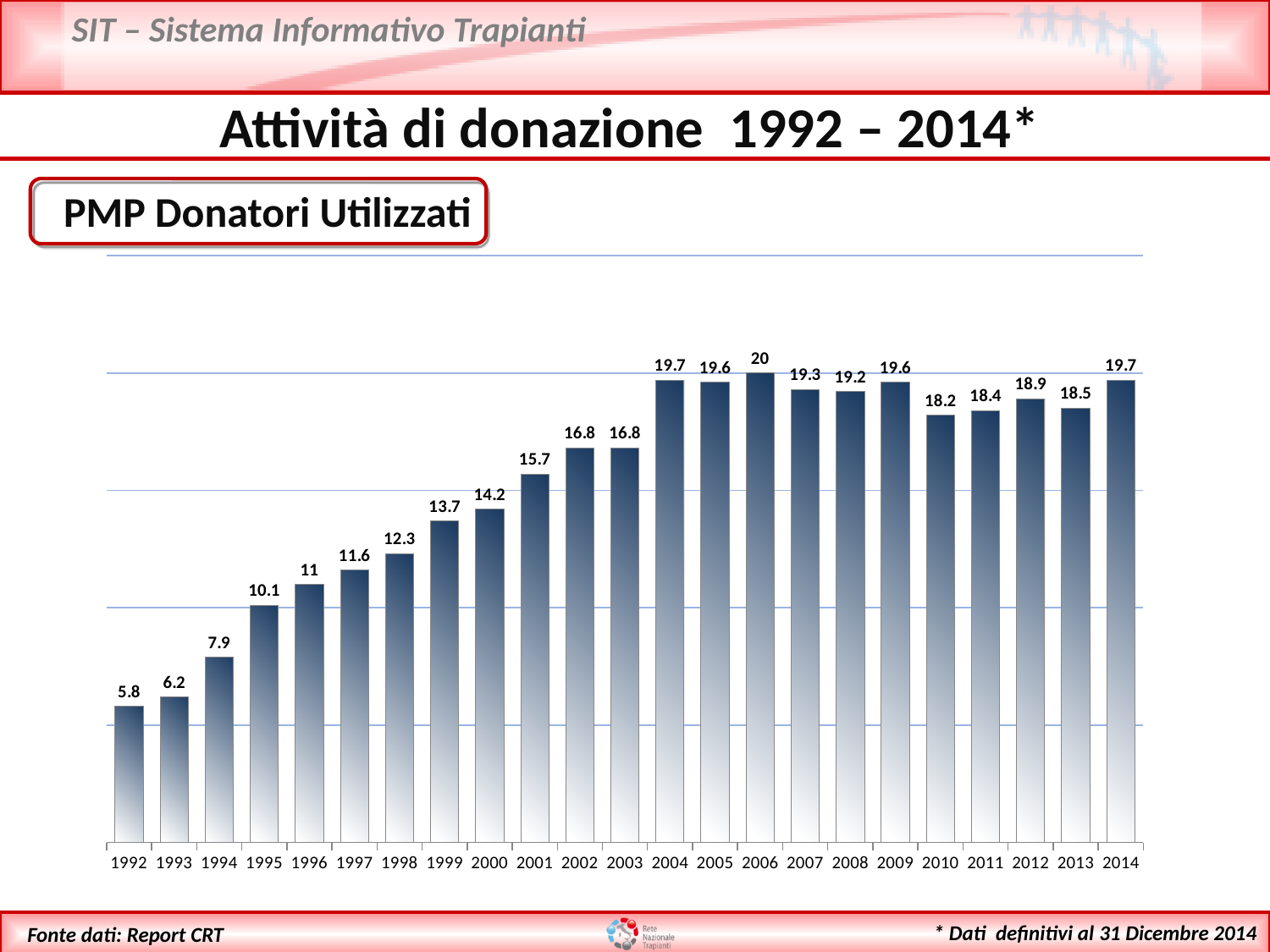
What is the value shown for 2014? 19.7 How many years are shown on the x axis? 23 Which year has the highest value? 2006 What is the difference between the values for 2004 and 2003? 2.9 What kind of chart is this? bar chart Which year has the lowest value? 1992 What is the PMP Donatori Utilizzati value for 1992? 5.8 What is the difference between the values for 2006 and 1992? 14.2 What is the value shown for 2010? 18.2 Do the values generally rise or fall from 1992 to 2006? rise What is the value shown for 2006? 20 Which is larger, the value for 2012 or the value for 2013? 2012